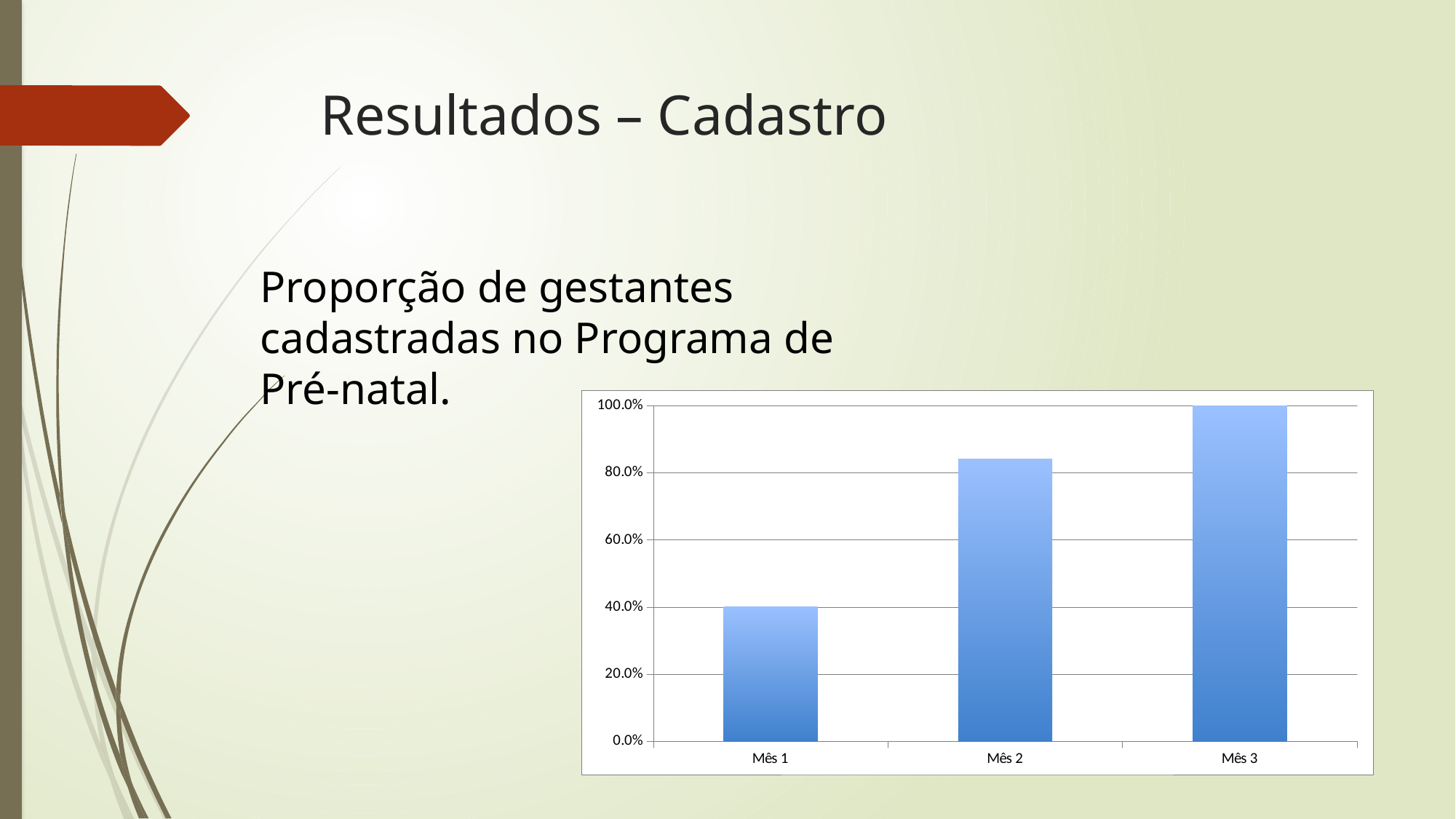
Which is larger, the value for Mês 1 or the value for Mês 2? Mês 2 Is the value for Mês 2 greater or less than 80.0%? greater What is the text above the chart describing what it shows? Proporção de gestantes cadastradas no Programa de Pré-natal. What kind of chart is shown on the slide? bar chart What is the highest value shown on the y axis of the chart? 100.0% Which month has the lowest value in the chart? Mês 1 Is the value for Mês 1 greater or less than 60.0%? less Which month has the highest value in the chart? Mês 3 Do the values rise or fall from Mês 1 to Mês 3? rise How many categories (months) are shown on the x axis of the chart? 3 Is the value for Mês 1 greater or less than 20.0%? greater